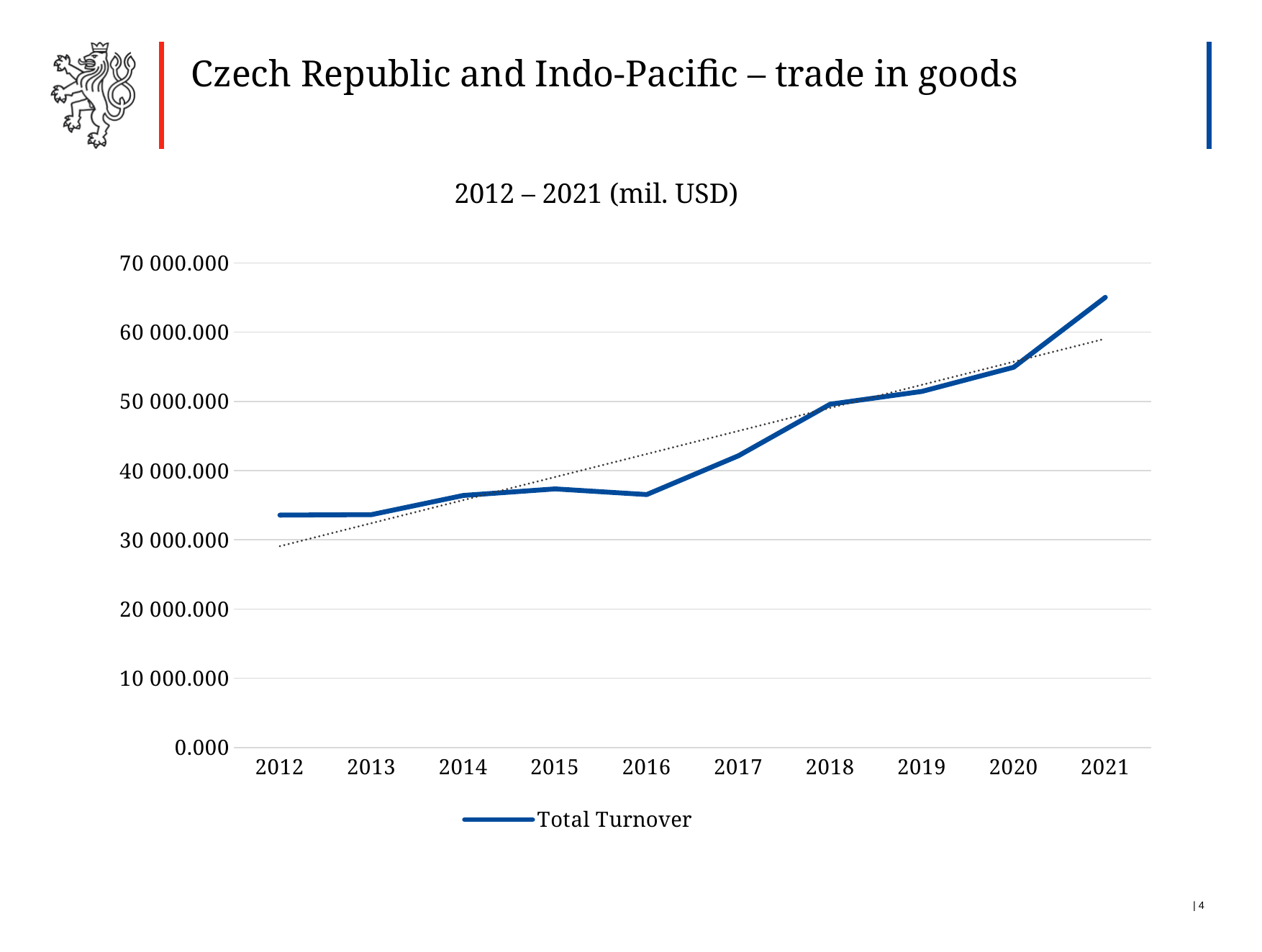
Does Total Turnover generally rise or fall from 2012 to 2021? rise Which year has the larger Total Turnover, 2015 or 2017? 2017 Is the value for Total Turnover in 2020 greater or less than 60 000.000? less How many years are plotted on the x axis of the chart? 10 What is the name of the series shown in the legend? Total Turnover Is the value for Total Turnover in 2012 greater or less than 30 000.000? greater Is the value for Total Turnover in 2016 greater or less than 40 000.000? less What is the title of the chart? 2012 – 2021 (mil. USD) How many series does the chart's legend list? 1 In which year is Total Turnover highest? 2021 What kind of chart is shown on the slide? line chart